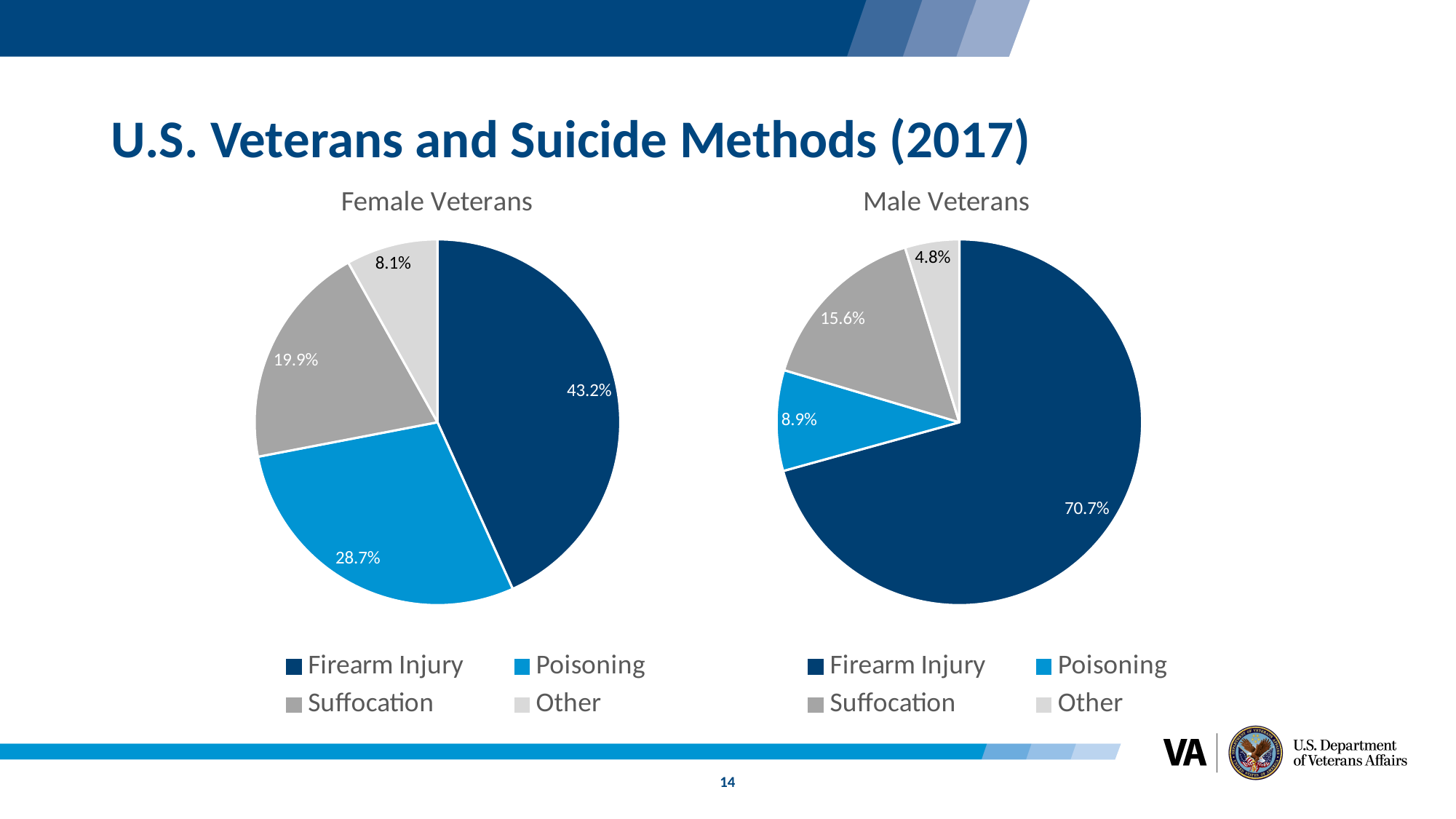
What is the title of the slide containing the two charts? U.S. Veterans and Suicide Methods (2017) In the Male Veterans chart, what share is Other? 4.8% What kind of chart is the Female Veterans chart? Pie chart In the Female Veterans chart, which method has the smallest slice? Other In the Female Veterans chart, what share is Firearm Injury? 43.2% What is the difference between the Firearm Injury share in the Male Veterans chart and the Firearm Injury share in the Female Veterans chart? 27.5% In the Female Veterans chart, what share is Suffocation? 19.9% Which is larger: Poisoning in the Female Veterans chart or Suffocation in the Male Veterans chart? Poisoning in the Female Veterans chart In the Male Veterans chart, what share is Poisoning? 8.9% In the Male Veterans chart, which method has the largest slice? Firearm Injury How many slices does the Male Veterans chart have? 4 In the Female Veterans chart, what is the difference between the Poisoning and Suffocation shares? 8.8%